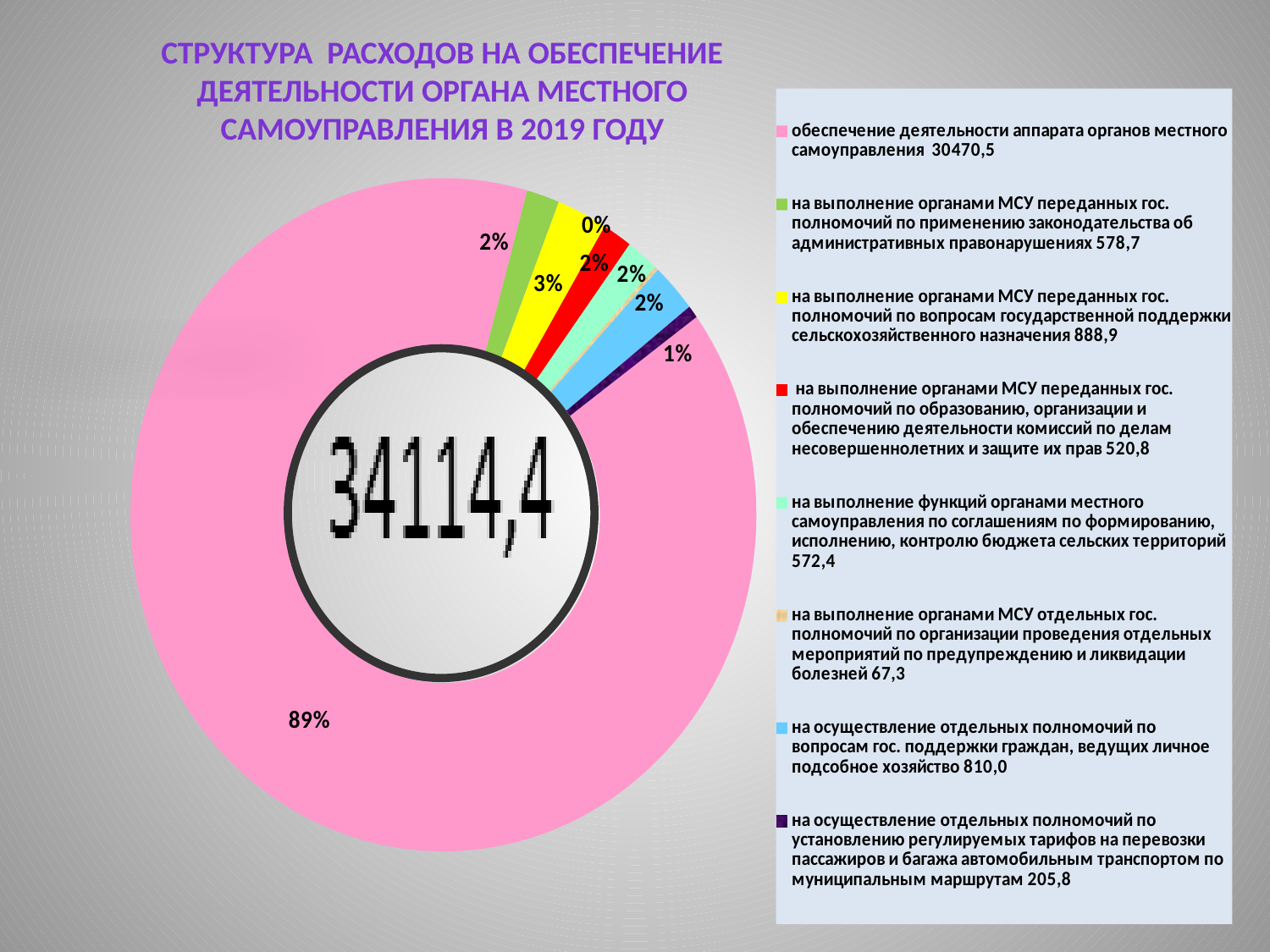
What value is shown in the legend for полномочий по организации проведения отдельных мероприятий по предупреждению и ликвидации болезней? 67,3 What kind of chart is shown on the slide? doughnut chart Which category has the smallest value in the legend? полномочий по организации проведения отдельных мероприятий по предупреждению и ликвидации болезней (67,3) What is the difference between the value for государственной поддержки сельскохозяйственного назначения (888,9) and the value for применению законодательства об административных правонарушениях (578,7)? 310,2 Which category has the largest share of the pie? обеспечение деятельности аппарата органов местного самоуправления How many slices does the pie chart have? 8 What total value is printed in the centre of the pie chart? 34114,4 Which is larger: the value for поддержки граждан, ведущих личное подсобное хозяйство (810,0) or the value for установлению регулируемых тарифов на перевозки пассажиров (205,8)? поддержки граждан, ведущих личное подсобное хозяйство (810,0) What value is shown in the legend for обеспечение деятельности аппарата органов местного самоуправления? 30470,5 What value is shown in the legend for полномочий по вопросам государственной поддержки сельскохозяйственного назначения? 888,9 What share of the pie does the slice for обеспечение деятельности аппарата органов местного самоуправления take? 89% How many entries does the legend list? 8